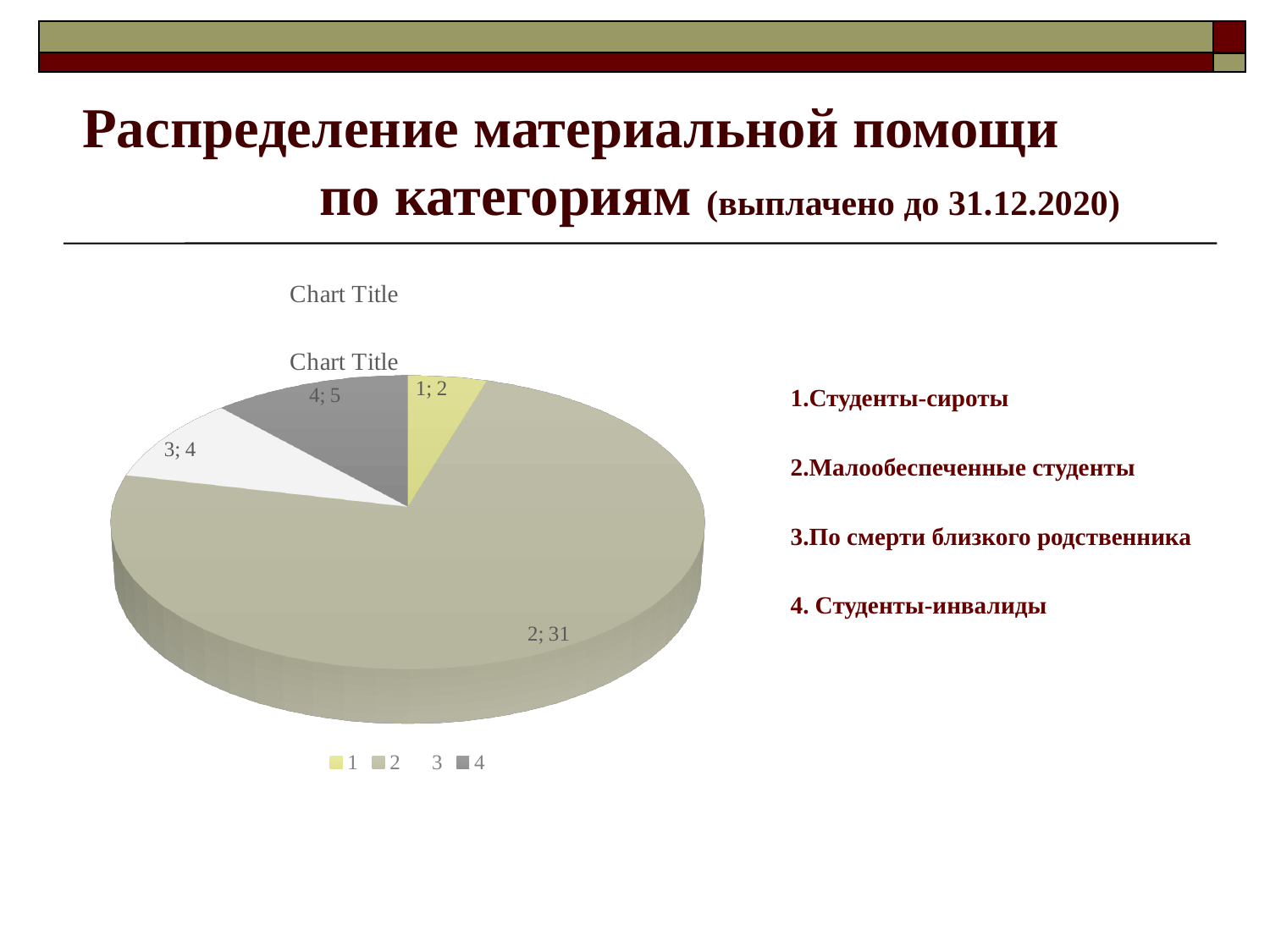
Which is larger, the value for category 3 or the value for category 4? Category 4 Which category has the largest slice in the pie chart? 2 What is the total of all the values shown in the pie chart? 42 What is the value for category 4 in the pie chart? 5 What is the value for category 2 in the pie chart? 31 What is the value for category 1 in the pie chart? 2 What type of chart is shown on the slide? Pie chart Which category has the smallest slice in the pie chart? 1 What is the value for category 3 in the pie chart? 4 How many slices does the pie chart have? 4 What is the difference between the values for category 2 and category 4? 26 What title is displayed above the pie chart? Chart Title